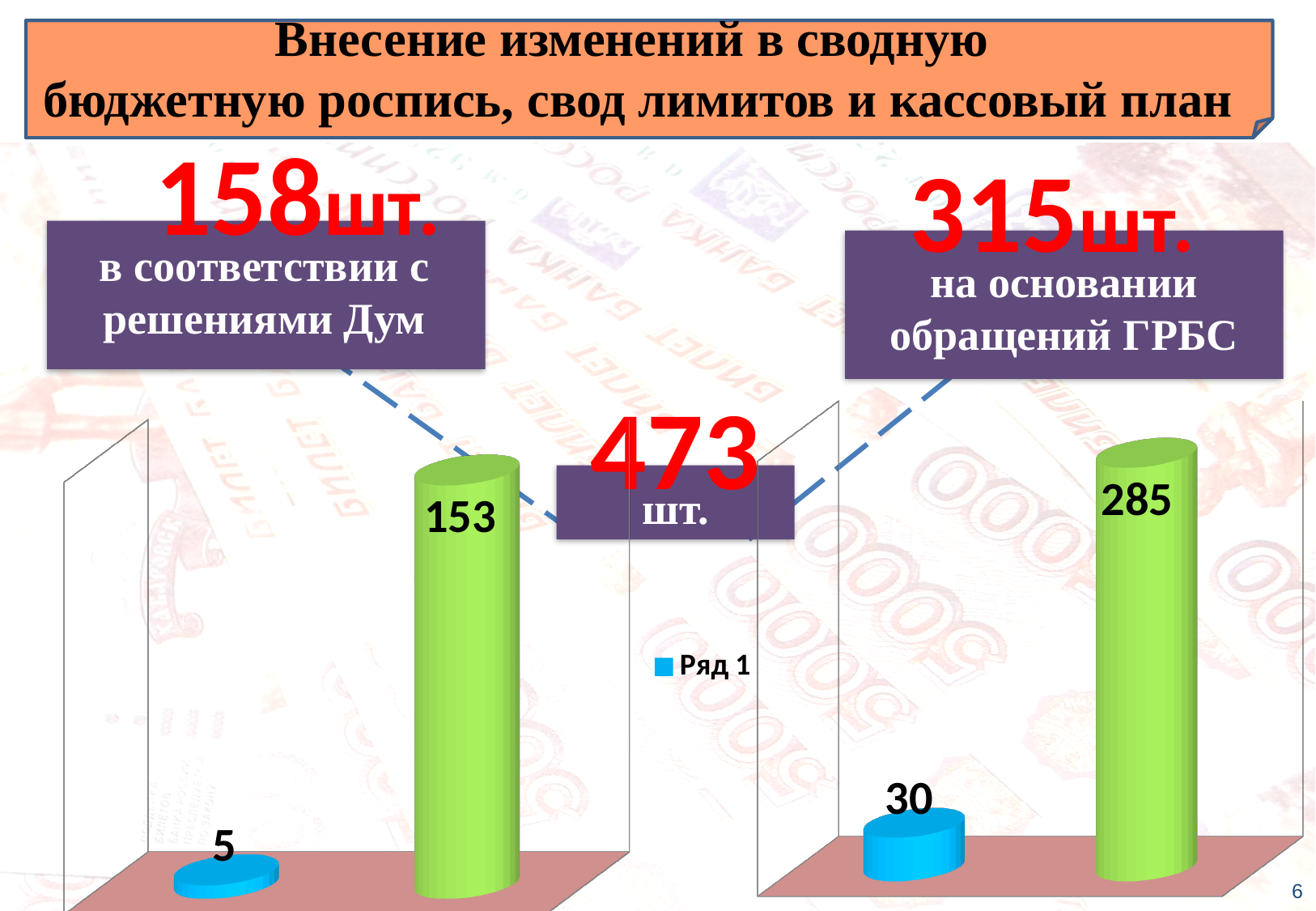
What type of chart is used on this slide? bar chart How many bars are plotted in the left chart (в соответствии с решениями Дум)? 2 In the right chart (на основании обращений ГРБС), which bar has the lowest value? the blue bar (30) Which is larger: the green bar in the left chart or the green bar in the right chart? the green bar in the right chart (285) In the right chart (на основании обращений ГРБС), what is the difference between the green bar and the blue bar? 255 In the left chart (в соответствии с решениями Дум), what is the difference between the green bar and the blue bar? 148 In the left chart (в соответствии с решениями Дум), what value is printed on the short blue bar? 5 In the left chart (в соответствии с решениями Дум), which bar has the highest value? the green bar (153) In the left chart (в соответствии с решениями Дум), what value is printed on the tall green bar? 153 In the right chart (на основании обращений ГРБС), what value is printed on the tall green bar? 285 What is the legend entry shown between the two charts? Ряд 1 In the right chart (на основании обращений ГРБС), what value is printed on the short blue bar? 30